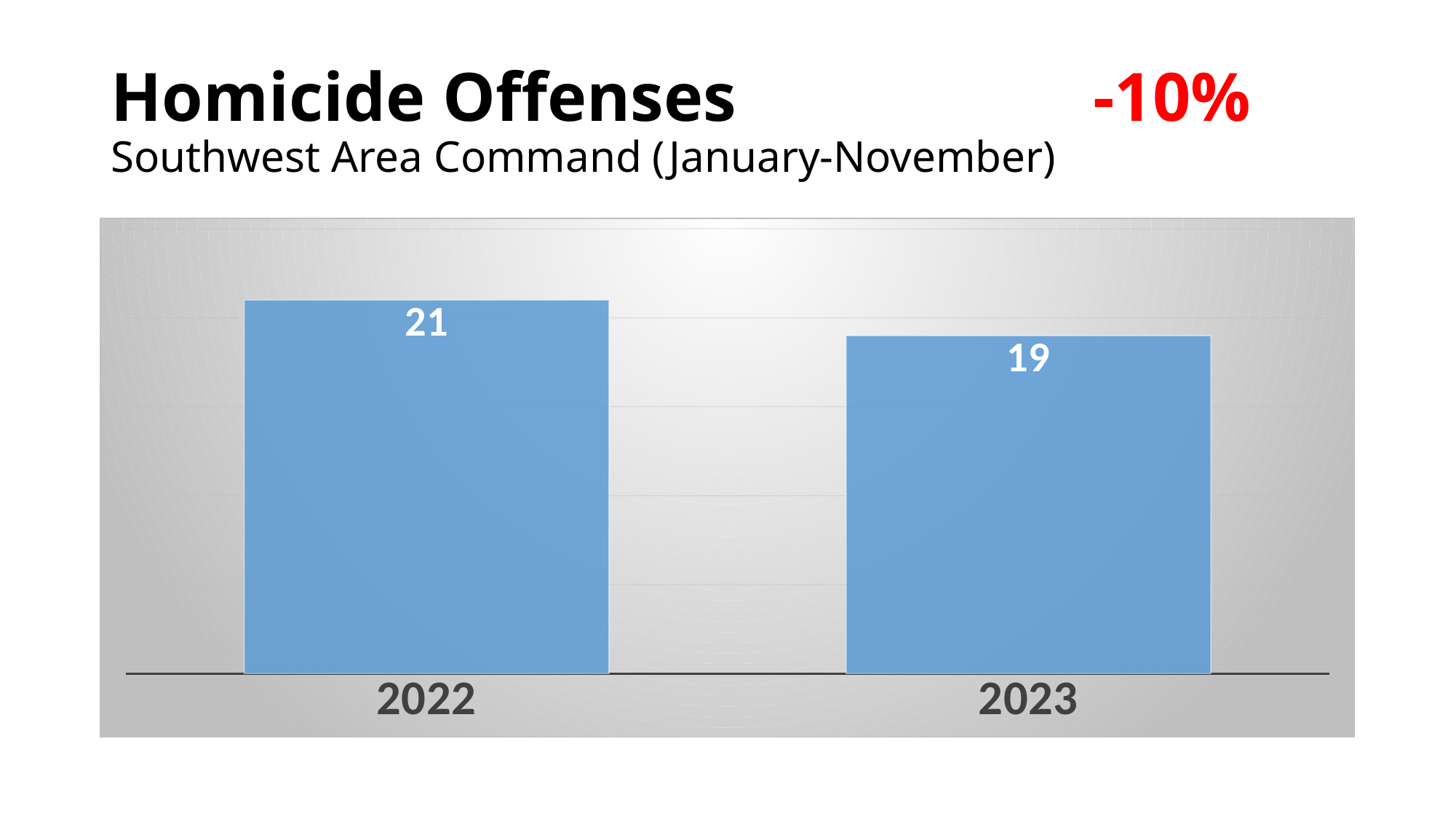
What percentage change is shown in red on the slide? -10% Which year has the higher value? 2022 Do the values rise or fall from 2022 to 2023? fall Which year has the lower value? 2023 What is the value for 2023? 19 What is the difference between the 2022 and 2023 values? 2 What is the value for 2022? 21 What is the title of the chart? Homicide Offenses What kind of chart is shown on the slide? bar chart Is the value for 2022 larger or smaller than the value for 2023? larger How many categories are shown on the x axis? 2